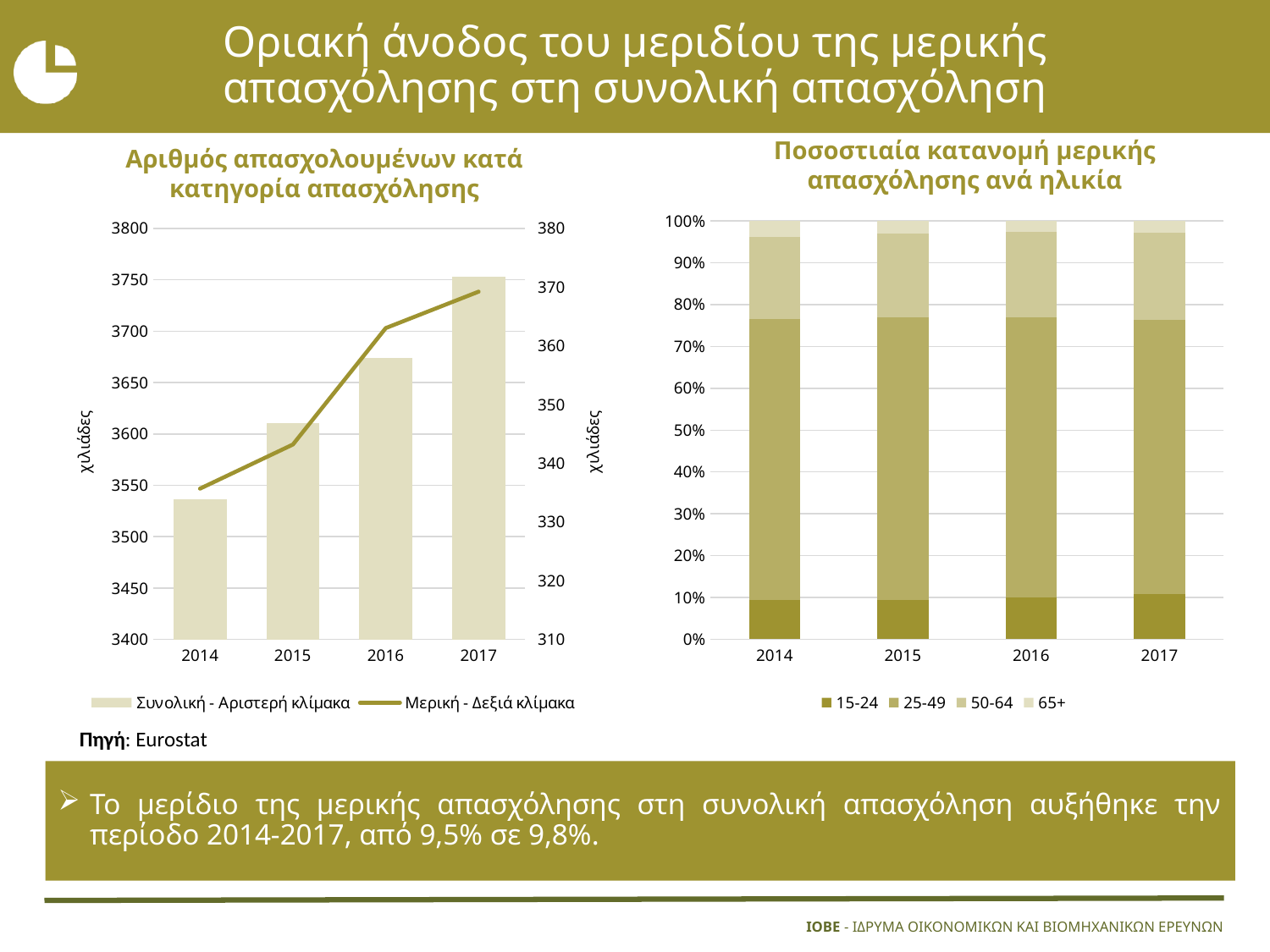
In the left chart, how many years are shown on the x axis? 4 In the left chart, how many series does the legend list? 2 In the left chart, is the 'Συνολική' bar for 2014 greater or less than 3550? less In the right chart, how many age groups does the legend list? 4 In the right chart, which age group has the largest share of part-time employment in 2014? 25-49 What kind of chart is the left chart, 'Αριθμός απασχολουμένων κατά κατηγορία απασχόλησης'? A combined bar and line chart In the left chart, is the 'Μερική' line value for 2017 greater or less than 360? greater In the left chart, which year has the highest 'Συνολική' bar? 2017 What kind of chart is the right chart, 'Ποσοστιαία κατανομή μερικής απασχόλησης ανά ηλικία'? A stacked bar chart In the left chart, do the bars for 'Συνολική' rise or fall from 2014 to 2017? Rise In the left chart, which year has the lowest value on the 'Μερική' line? 2014 In the right chart, which age group has the smallest share of part-time employment in 2017? 65+